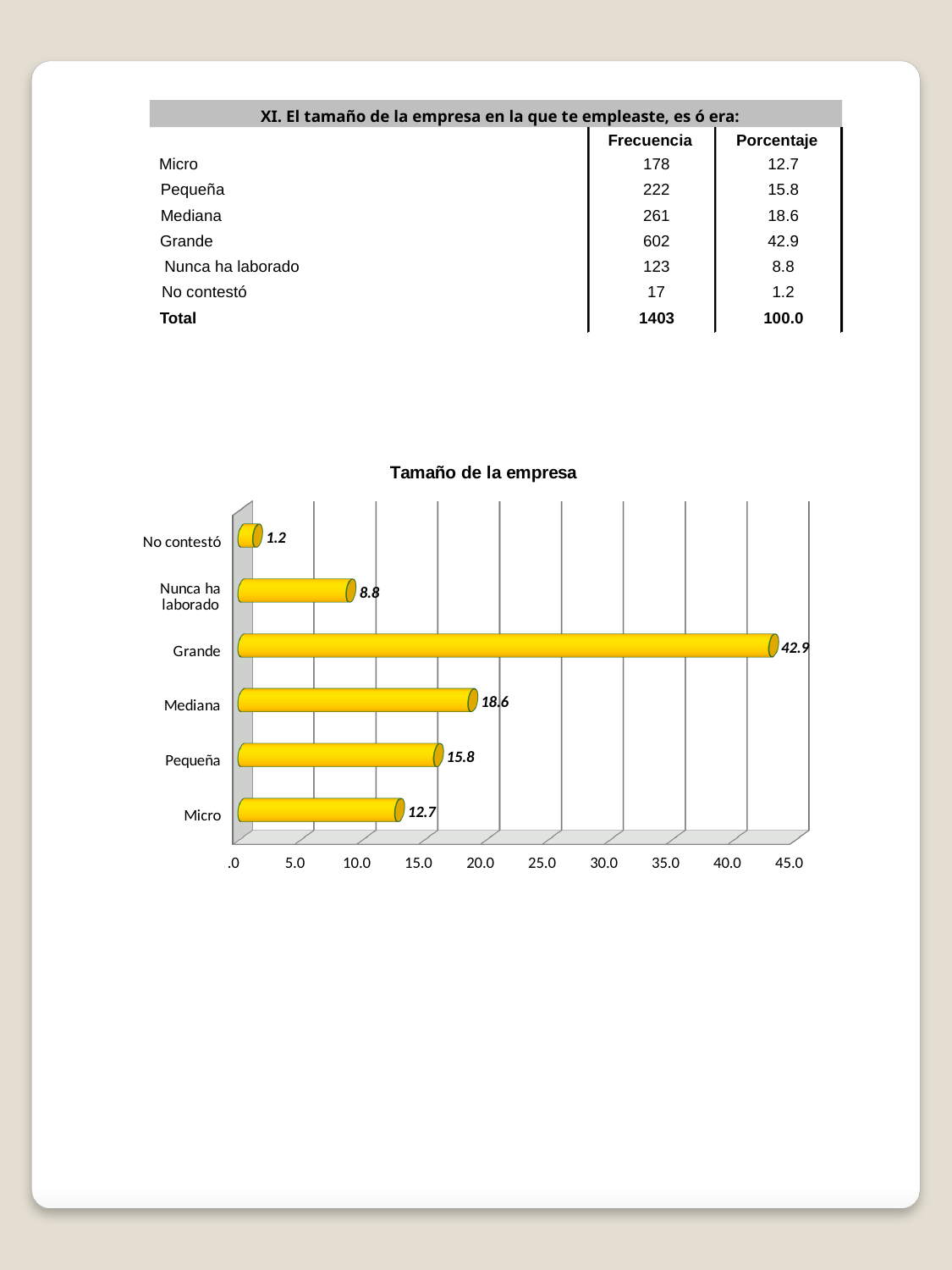
Is the value for Micro greater or less than 10.0? greater Which is larger, the value for Mediana or the value for Pequeña? Mediana Which category has the highest value in the chart? Grande What is the difference between the values for Grande and Mediana? 24.3 What kind of chart is shown on the slide? bar chart What is the value for Grande in the chart? 42.9 What is the value for Mediana in the chart? 18.6 Which category has the lowest value in the chart? No contestó What is the value for Nunca ha laborado in the chart? 8.8 What is the title of the chart? Tamaño de la empresa What is the difference between the values for Pequeña and Micro? 3.1 How many categories are shown in the chart? 6